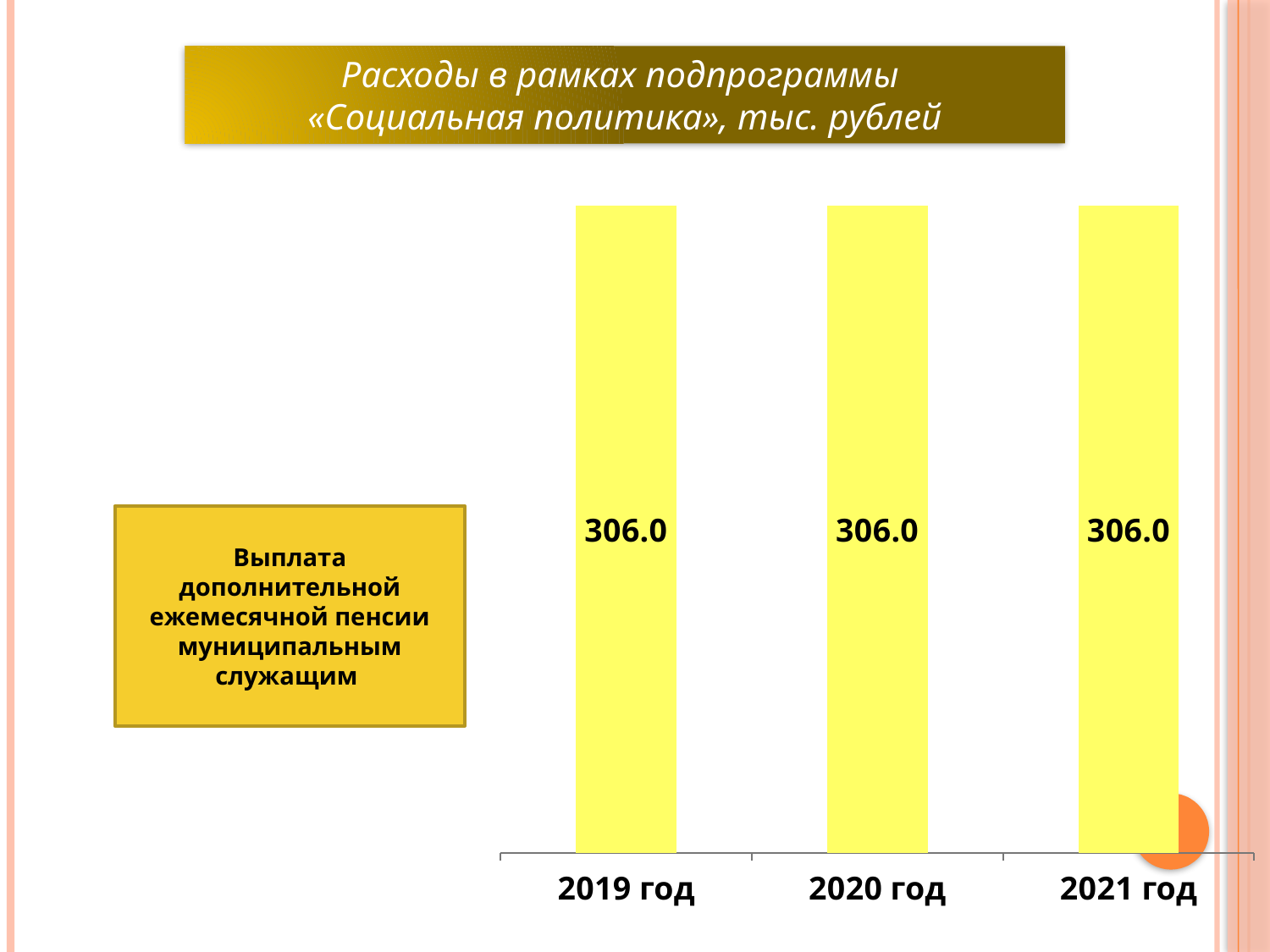
Do the values rise, fall or stay the same from 2019 год to 2021 год? Stay the same What is the difference between the values for 2020 год and 2019 год? 0.0 How many categories are shown on the x axis? 3 What is the total of the values for 2019 год, 2020 год and 2021 год? 918.0 What kind of chart is shown on the slide? Bar chart What is the value for 2019 год? 306.0 What is the title of the chart? Расходы в рамках подпрограммы «Социальная политика», тыс. рублей What is the value for 2020 год? 306.0 What colour are the bars in the chart? Yellow What is the value for 2021 год? 306.0 What is the difference between the values for 2021 год and 2019 год? 0.0